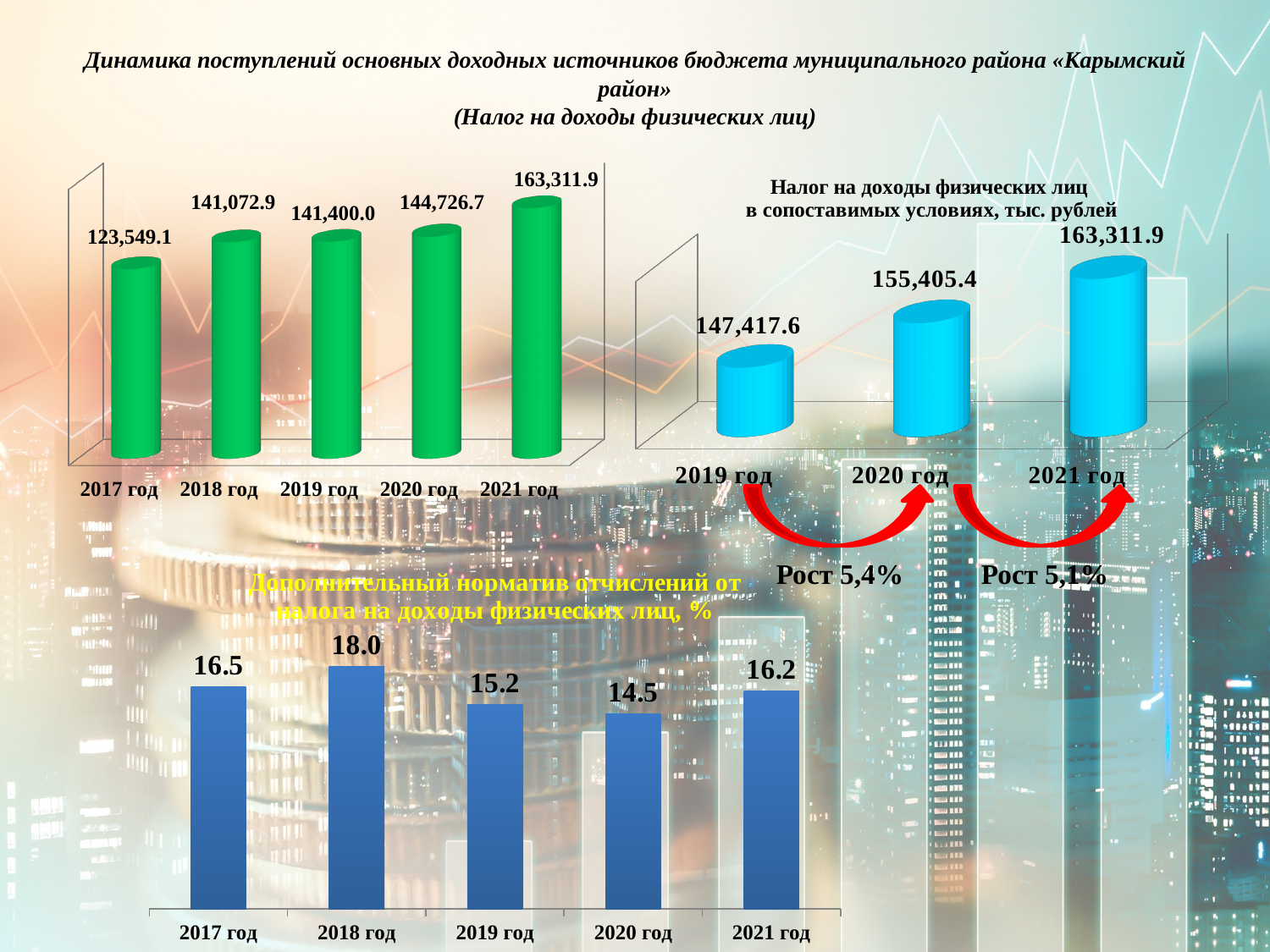
In the chart titled 'Дополнительный норматив отчислений от налога на доходы физических лиц, %', which is larger, the value for 2017 год or 2021 год? 2017 год In the top-left green bar chart, which year has the lowest value? 2017 год In the chart titled 'Налог на доходы физических лиц в сопоставимых условиях, тыс. рублей', do the values rise or fall from 2019 год to 2021 год? rise In the chart titled 'Налог на доходы физических лиц в сопоставимых условиях, тыс. рублей', what is the difference between 2020 год and 2019 год? 7,987.8 In the top-left green bar chart, what is the value for 2017 год? 123,549.1 What kind of chart is the bottom chart titled 'Дополнительный норматив отчислений от налога на доходы физических лиц, %'? bar chart In the top-left green bar chart, what is the value for 2021 год? 163,311.9 In the chart titled 'Налог на доходы физических лиц в сопоставимых условиях, тыс. рублей', what is the value for 2020 год? 155,405.4 In the top-left green bar chart, what is the difference between the 2021 год and 2020 год values? 18,585.2 In the chart titled 'Дополнительный норматив отчислений от налога на доходы физических лиц, %', which year has the highest value? 2018 год In the chart titled 'Дополнительный норматив отчислений от налога на доходы физических лиц, %', what is the value for 2020 год? 14.5 In the top-left green bar chart, how many years are shown? 5